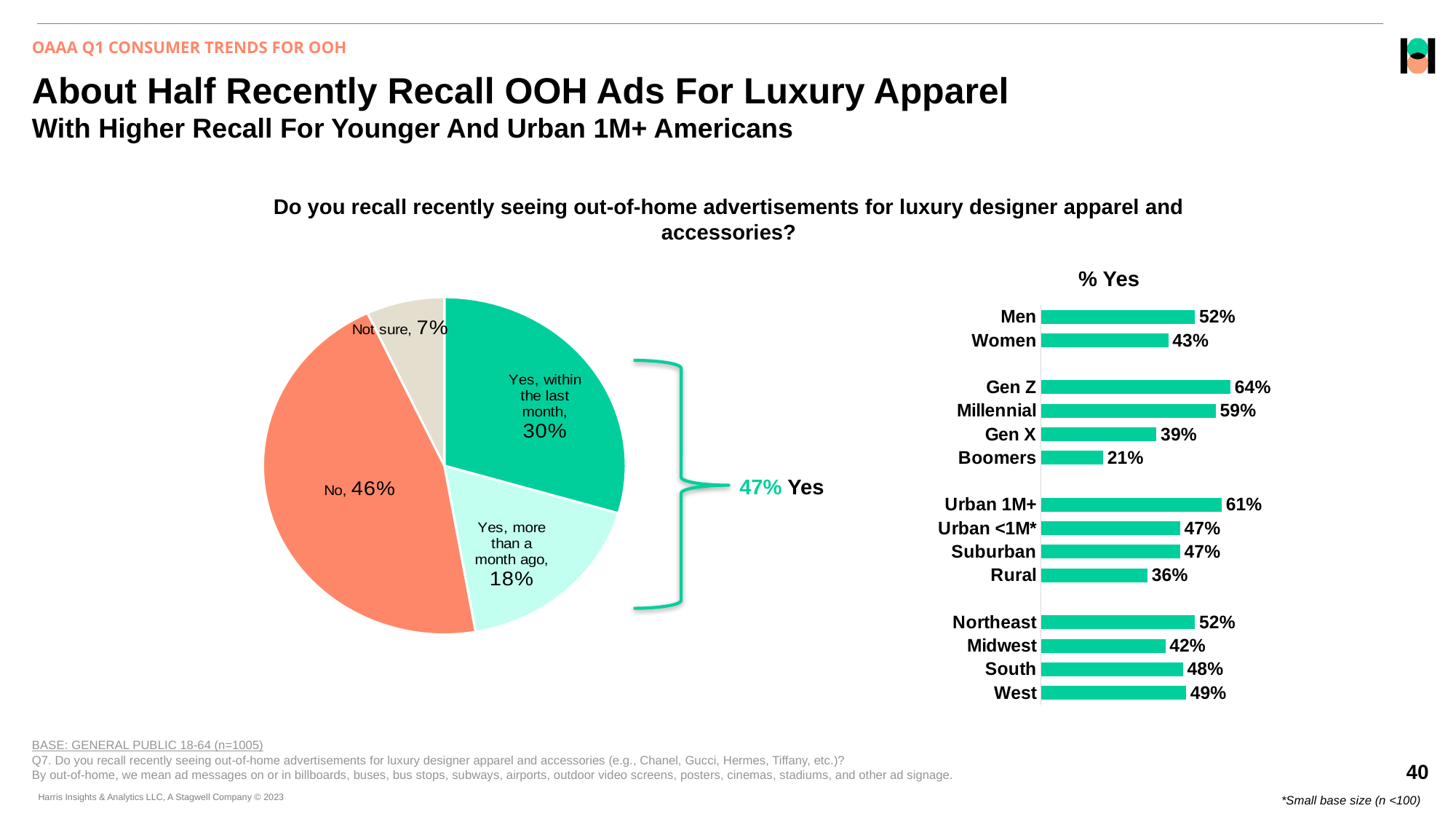
In the pie chart on the left, what is the combined share of the two "Yes" slices? 47% In the "% Yes" bar chart on the right, what is the value for Gen Z? 64% In the "% Yes" bar chart on the right, what is the value for Rural? 36% What type of chart is shown on the right side of the slide? Bar chart In the "% Yes" bar chart on the right, which category has the highest value? Gen Z In the pie chart on the left, what share answered "Yes, within the last month"? 30% In the pie chart on the left, which response has the smallest slice? Not sure In the pie chart on the left, how many slices are there? 4 In the "% Yes" bar chart on the right, which is larger, Urban 1M+ or Suburban? Urban 1M+ In the pie chart on the left, what share of respondents answered "No"? 46% In the "% Yes" bar chart on the right, what is the difference between Men and Women? 9% In the "% Yes" bar chart on the right, which category has the lowest value? Boomers